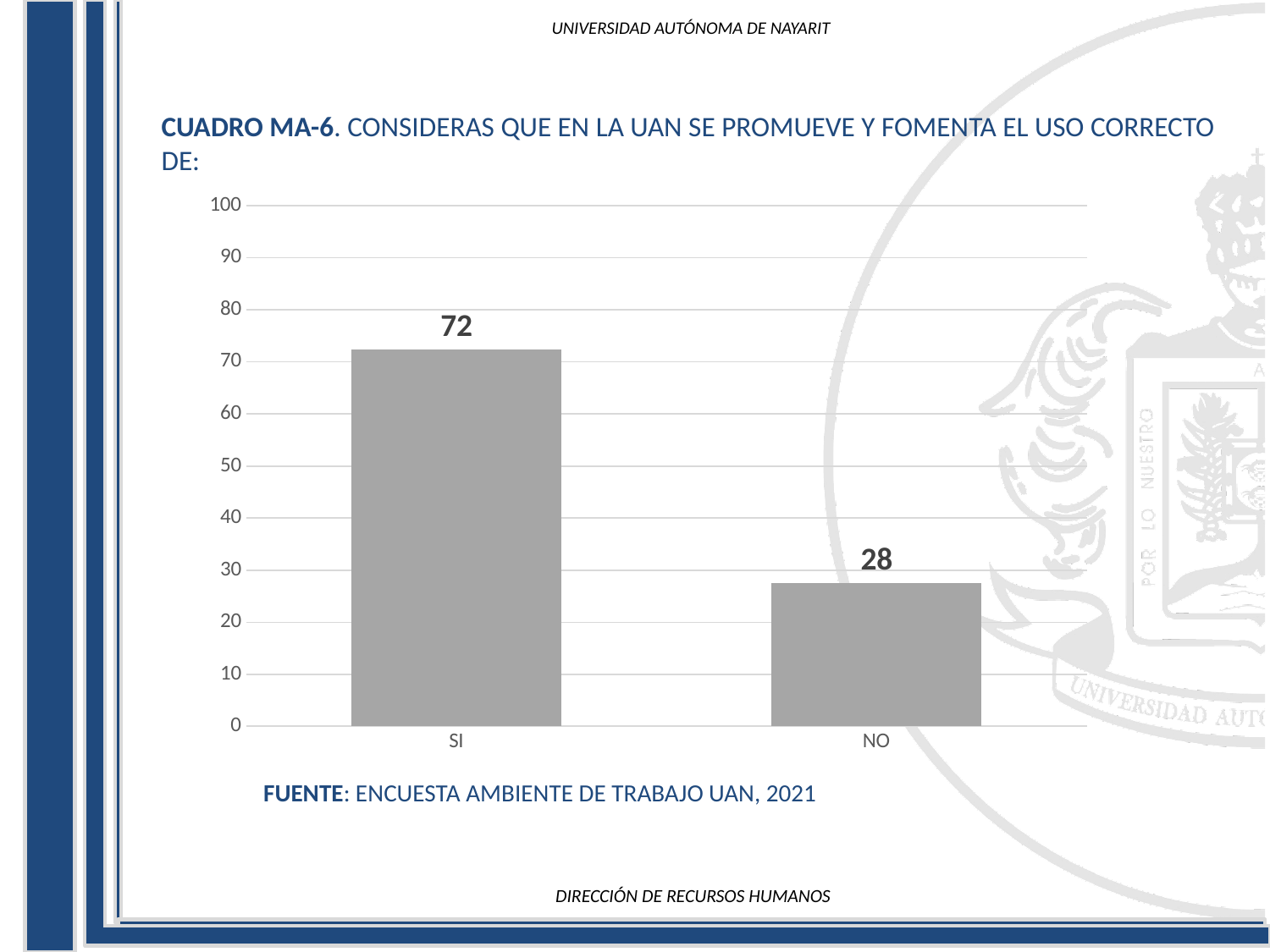
What is the total of the two bars? 100 Is the value for NO greater or less than 30? less What kind of chart is shown on the slide? bar chart What is the value for SI? 72 What is the value for NO? 28 What is the difference between the values for SI and NO? 44 What is the source cited below the chart? ENCUESTA AMBIENTE DE TRABAJO UAN, 2021 Which category has the lowest value? NO Is the value for SI greater or less than 70? greater Which category has the highest value? SI How many categories are shown on the x axis? 2 Which is larger, the value for SI or the value for NO? SI